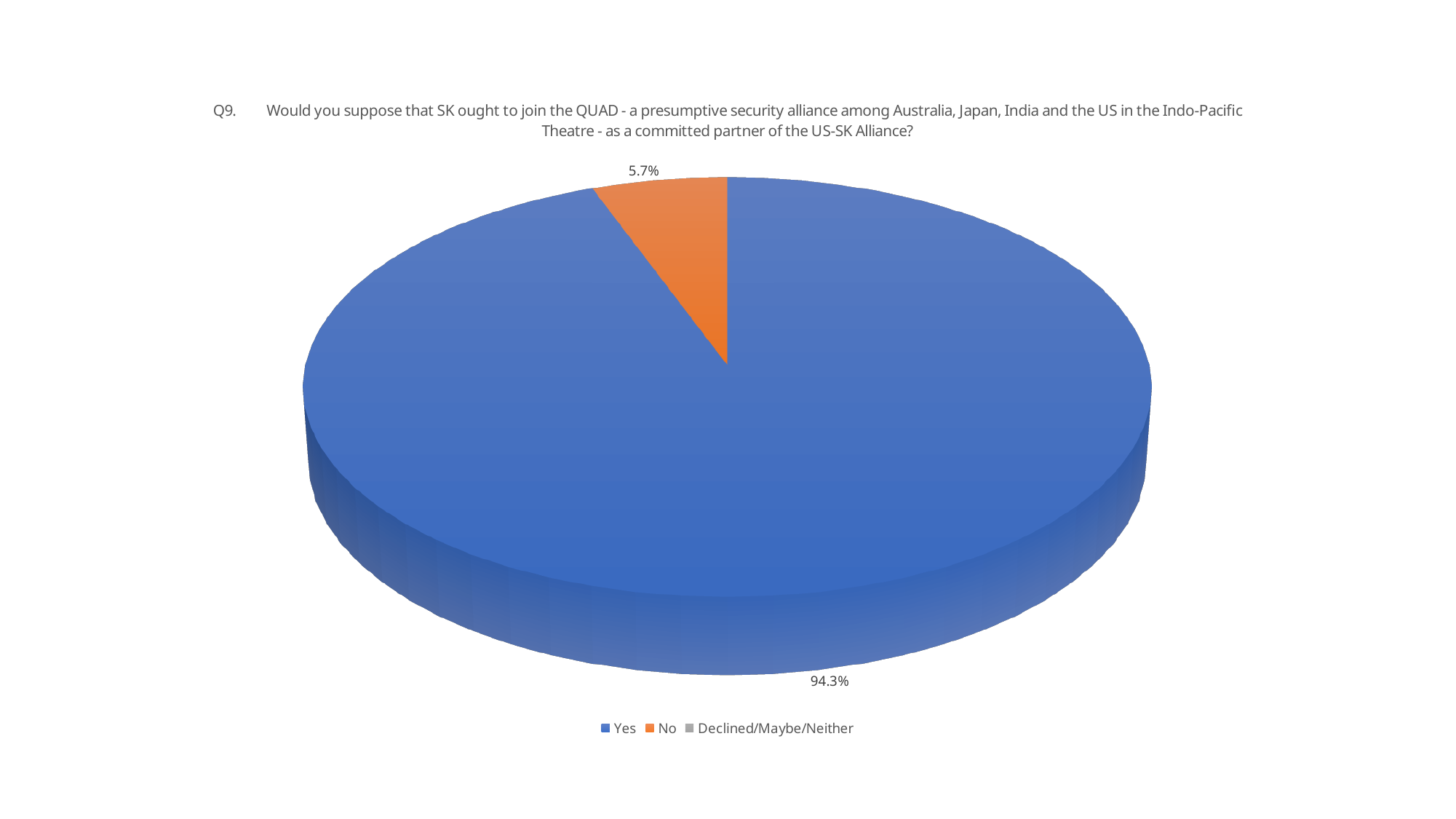
What is the difference in percentage points between the Yes and No shares? 88.6 Is the share for No greater or less than 10%? less What share of respondents answered No? 5.7% What colour is the No slice? orange How many entries does the legend list? 3 Which of the two visible slices, Yes or No, is larger? Yes Which response has the largest share of the pie? Yes Is the share for Yes greater or less than 90%? greater What colour is the Yes slice? blue What share of respondents answered Yes? 94.3% What kind of chart is shown on the slide? pie chart